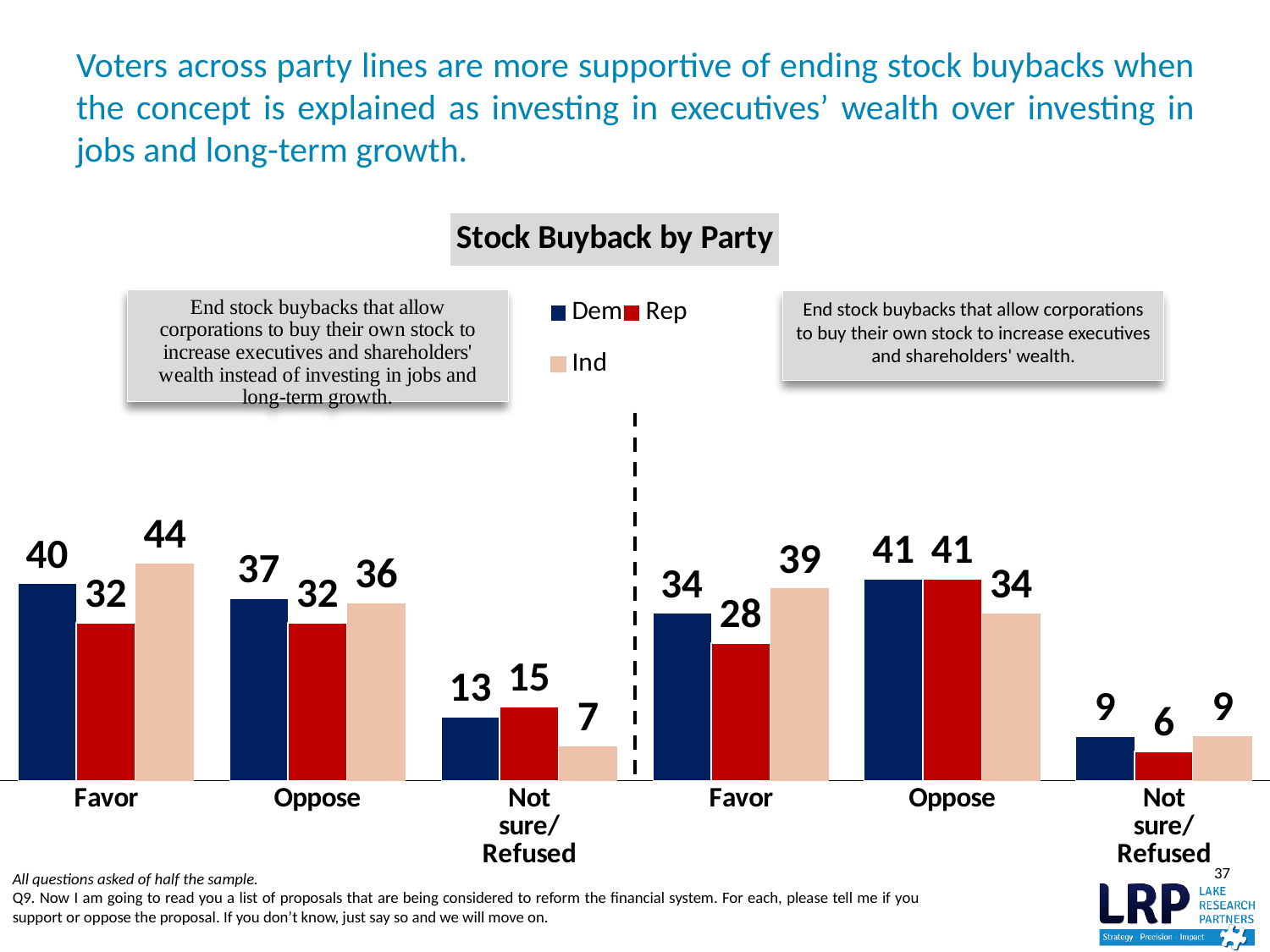
In the Stock Buyback by Party chart, which colour represents Rep in the legend? Red In the Stock Buyback by Party chart, which party has the lowest Not sure/Refused value on the left half? Ind In the Stock Buyback by Party chart, which party has the highest Favor value on the left half? Ind In the Stock Buyback by Party chart, what is the Ind value for Favor on the right half (the shorter wording)? 39 In the Stock Buyback by Party chart, what is the difference between the Ind Favor value on the left half (44) and the Ind Favor value on the right half (39)? 5 In the Stock Buyback by Party chart, on the right half, is the Rep Favor value or the Rep Oppose value larger? Oppose In the Stock Buyback by Party chart, what is the Rep value for Not sure/Refused on the right half? 6 In the Stock Buyback by Party chart, what is the difference between the Dem Oppose value and the Ind Oppose value on the right half? 7 In the Stock Buyback by Party chart, on the left half, is the Dem Favor value or the Dem Oppose value larger? Favor How many series does the legend of the Stock Buyback by Party chart list? 3 What kind of chart is the Stock Buyback by Party chart? Bar chart In the Stock Buyback by Party chart, what is the Dem value for Favor on the left half (the wording mentioning jobs and long-term growth)? 40